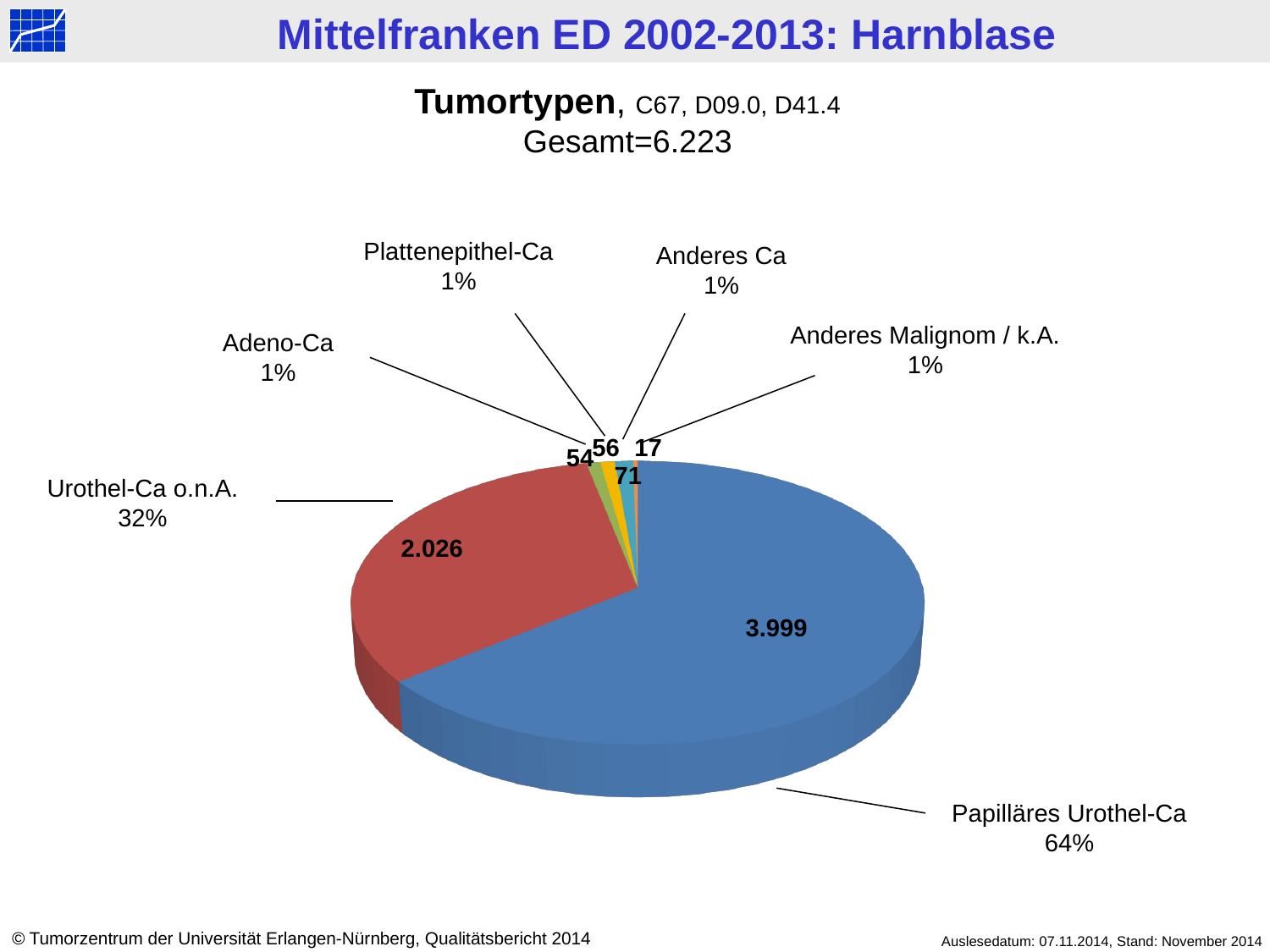
Which tumour type has the largest slice of the pie? Papilläres Urothel-Ca What kind of chart is shown on the slide? pie chart How many tumour type categories does the pie chart show? 6 What share of the pie does Papilläres Urothel-Ca represent? 64% What share of the pie does Urothel-Ca o.n.A. represent? 32% What total (Gesamt) is stated above the pie chart? 6.223 Which is larger, the slice for Papilläres Urothel-Ca or the slice for Urothel-Ca o.n.A.? Papilläres Urothel-Ca What is the value shown for Papilläres Urothel-Ca? 3.999 What is the difference between the values for Papilläres Urothel-Ca and Urothel-Ca o.n.A.? 1.973 What share of the pie does Adeno-Ca represent? 1% What is the value shown for Urothel-Ca o.n.A.? 2.026 What colour is the slice for Papilläres Urothel-Ca? blue